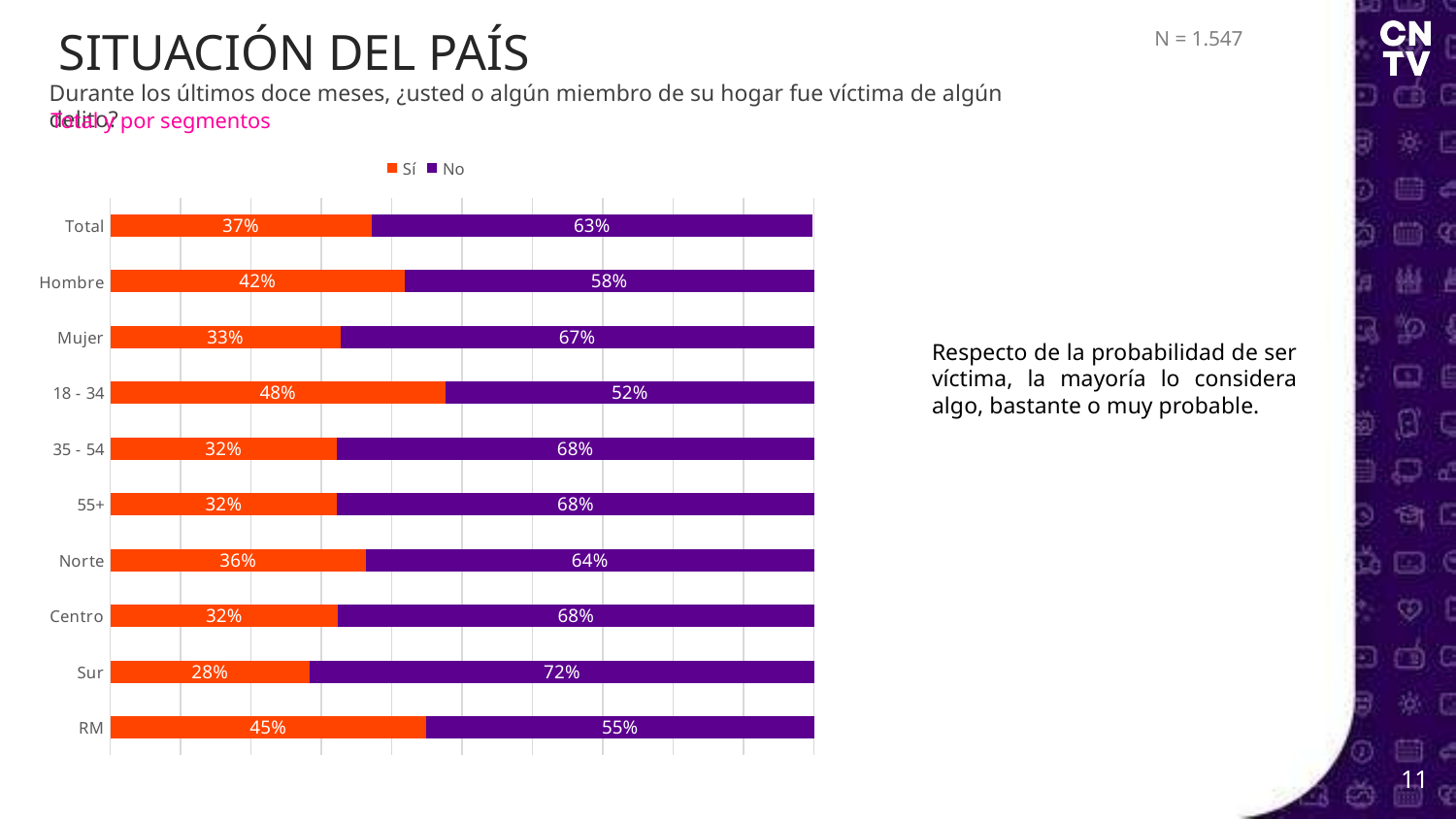
Which category has the lowest 'Sí' value? Sur What is the 'No' value for Sur? 72% Which is larger, the 'Sí' value for Norte or the 'Sí' value for Centro? Norte How many categories are shown on the chart? 10 What is the difference between the 'Sí' values for Hombre and Mujer? 9% What are the two series listed in the legend? Sí and No Which category has the highest 'Sí' value? 18 - 34 What kind of chart is shown on the slide? Stacked bar chart What is the 'Sí' value for Hombre? 42% What is the 'Sí' value for RM? 45% What is the total of the stacked bar for Total? 100% How many series does the legend list? 2